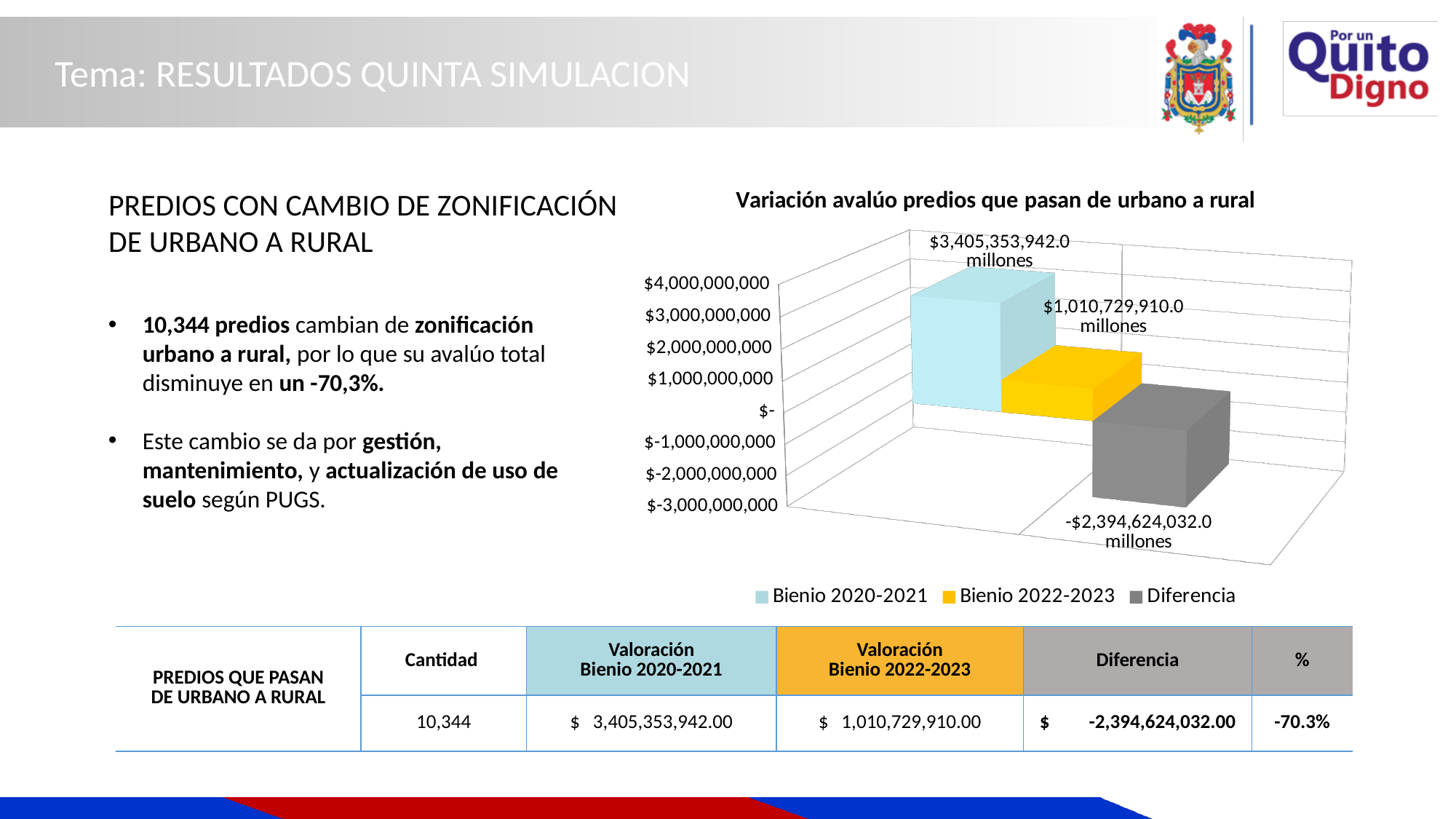
Is the value for Bienio 2022-2023 greater or less than $2,000,000,000? less What value is shown for Diferencia in the chart? -$2,394,624,032.0 millones Which is larger, the value for Bienio 2020-2021 or the value for Bienio 2022-2023? Bienio 2020-2021 What is the title of the chart? Variación avalúo predios que pasan de urbano a rural Which series has the highest value in the chart? Bienio 2020-2021 How many series does the chart legend list? 3 What value is shown for Bienio 2022-2023 in the chart? $1,010,729,910.0 millones What kind of chart is shown on the slide? bar chart Which series has the lowest value in the chart? Diferencia What value is shown for Bienio 2020-2021 in the chart? $3,405,353,942.0 millones Is the value for Bienio 2020-2021 greater or less than $3,000,000,000? greater By how much does the value for Bienio 2020-2021 exceed the value for Bienio 2022-2023? $2,394,624,032.0 millones